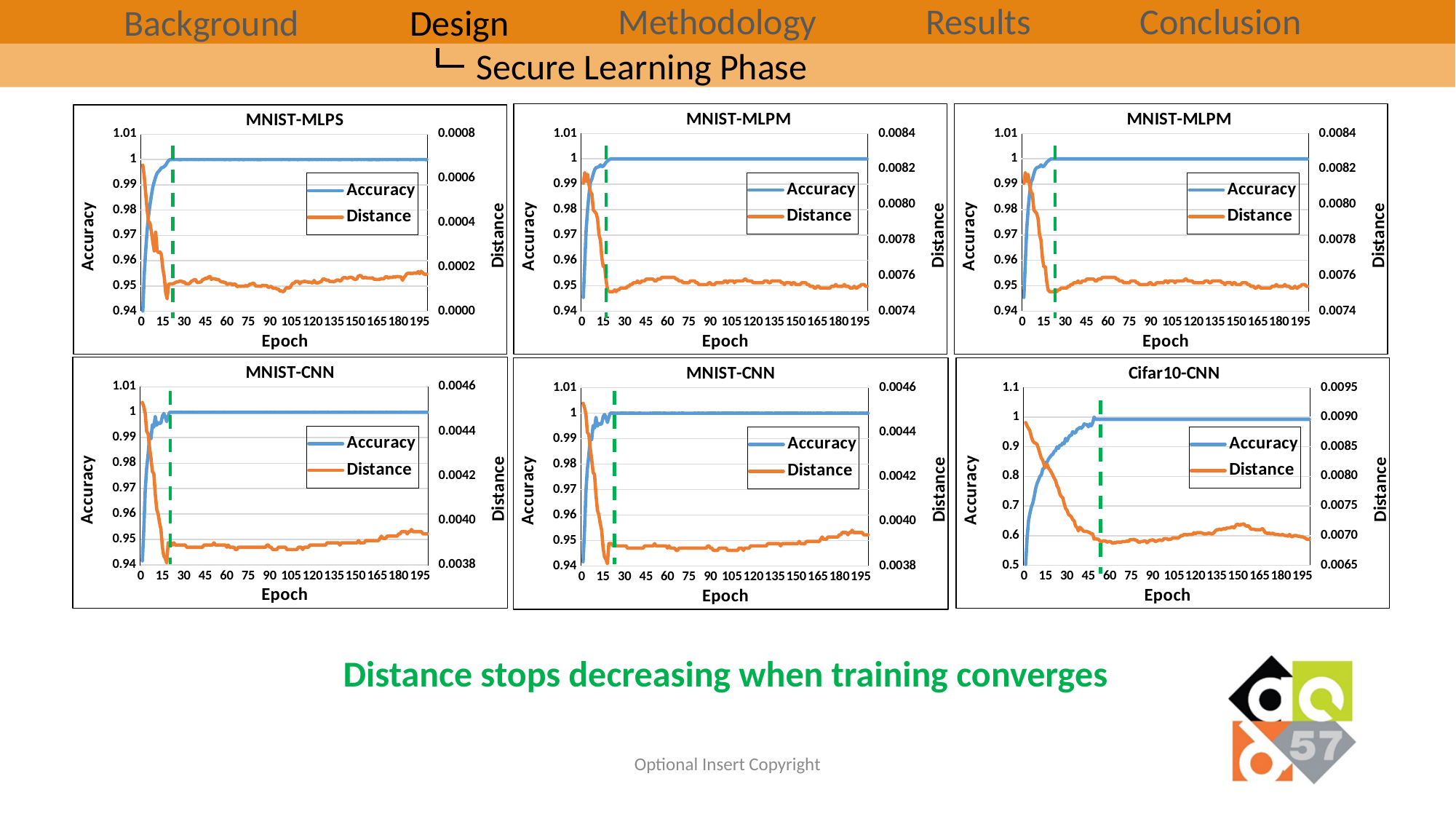
In the top-left chart titled MNIST-MLPS, what are the two series named in the legend? Accuracy and Distance In the top-left chart titled MNIST-MLPS, is the Distance value at epoch 0 greater or less than 0.0004? greater In the bottom-right chart titled Cifar10-CNN, is the Accuracy value at epoch 195 greater or less than 0.9? greater What kind of chart is the top-left chart titled MNIST-MLPS? line chart In the top-left chart titled MNIST-MLPS, is the Accuracy value at epoch 195 greater or less than 0.98? greater How many charts are shown on the slide? 6 In the bottom-right chart titled Cifar10-CNN, does the Distance series generally rise or fall as the epoch increases? fall In the bottom-right chart titled Cifar10-CNN, how many series does the legend list? 2 In the bottom-right chart titled Cifar10-CNN, does the Accuracy series rise or fall as the epoch increases? rise What is the title of the bottom-right chart? Cifar10-CNN